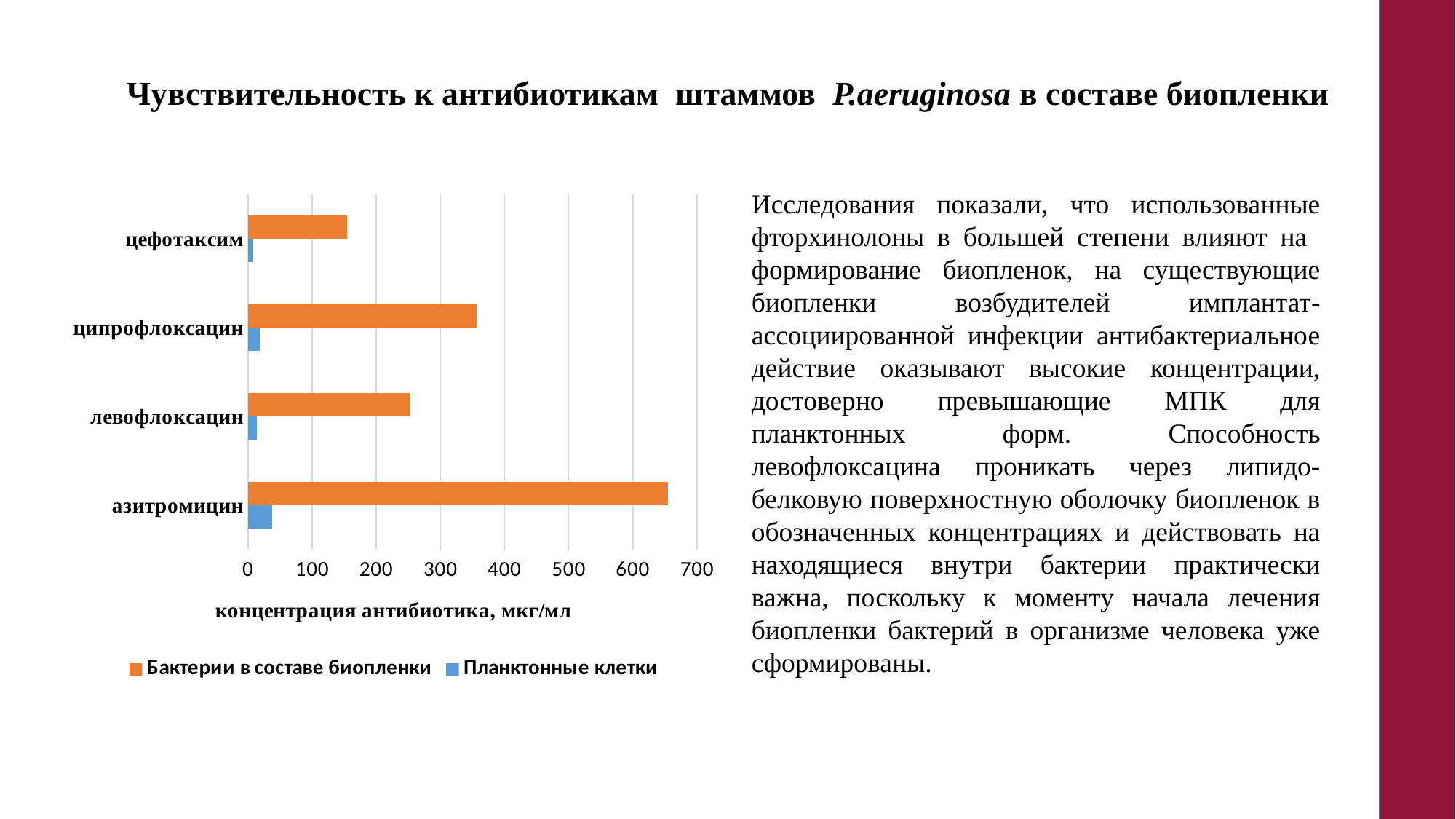
Which antibiotic has the lowest value for the series 'Бактерии в составе биопленки'? цефотаксим What is the title of the horizontal axis of the chart? концентрация антибиотика, мкг/мл Is the value for азитромицин in the series 'Планктонные клетки' greater or less than 100? less How many antibiotics (categories) are shown on the chart? 4 Is the value for ципрофлоксацин in the series 'Бактерии в составе биопленки' greater or less than 300? greater Is the value for левофлоксацин in the series 'Бактерии в составе биопленки' greater or less than 300? less What kind of chart is shown on the slide? bar chart For the series 'Бактерии в составе биопленки', which is larger: ципрофлоксацин or левофлоксацин? ципрофлоксацин Which antibiotic has the highest value for the series 'Бактерии в составе биопленки'? азитромицин How many series does the chart legend list? 2